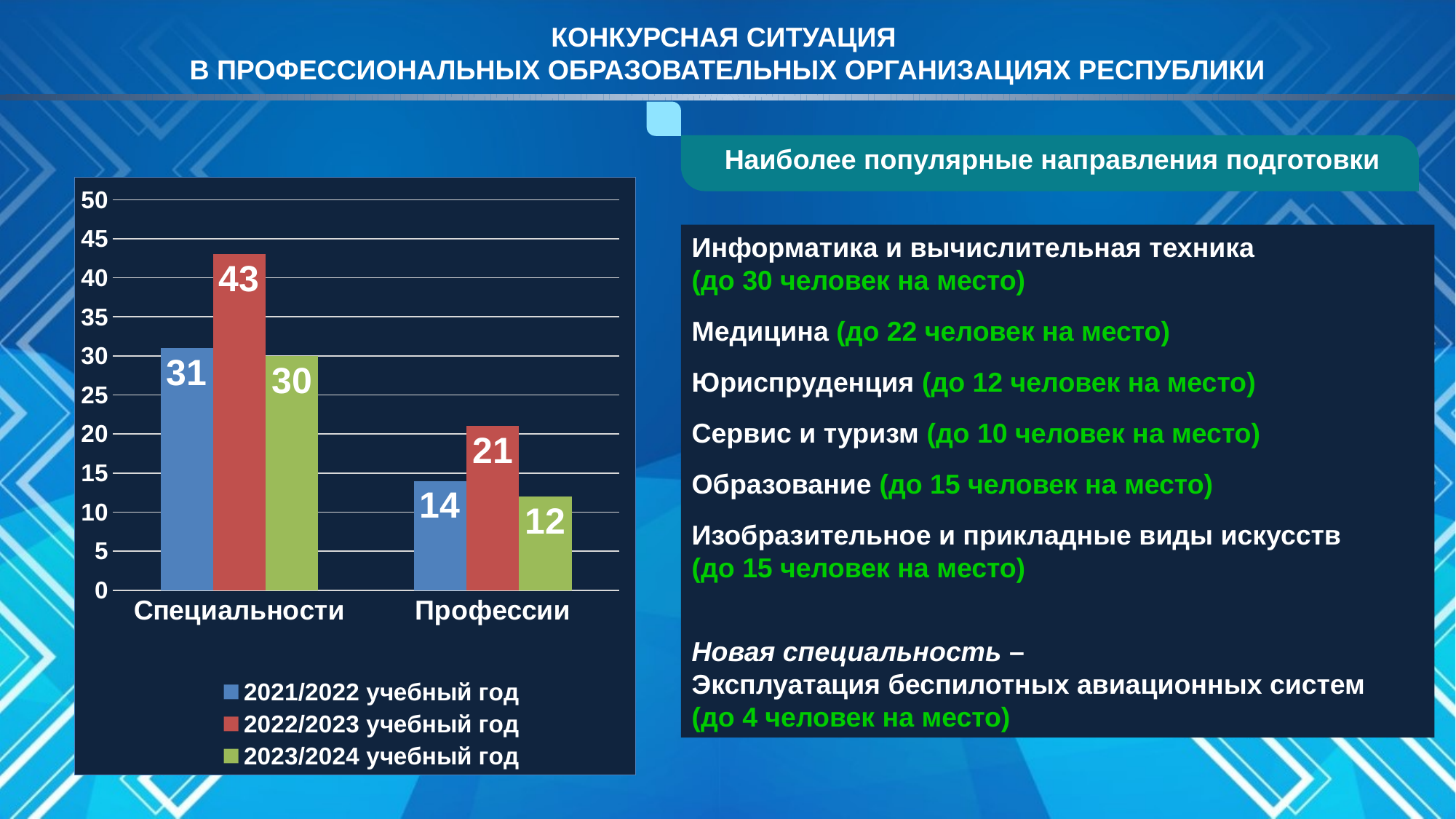
What is the value for Профессии in the 2021/2022 учебный год series? 14 Which series has the lowest value for Профессии? 2023/2024 учебный год What is the value for Специальности in the 2022/2023 учебный год series? 43 What is the difference between the 2022/2023 and 2023/2024 values for Профессии? 9 How many categories are shown on the x axis of the chart? 2 How many series does the chart legend list? 3 What is the value for Специальности in the 2023/2024 учебный год series? 30 Which series has the highest value for Специальности? 2022/2023 учебный год Which is larger: the 2021/2022 value for Специальности or the 2022/2023 value for Профессии? 2021/2022 value for Специальности What is the value for Профессии in the 2023/2024 учебный год series? 12 What is the difference between the 2022/2023 and 2021/2022 values for Специальности? 12 What kind of chart is shown on the slide? Bar chart